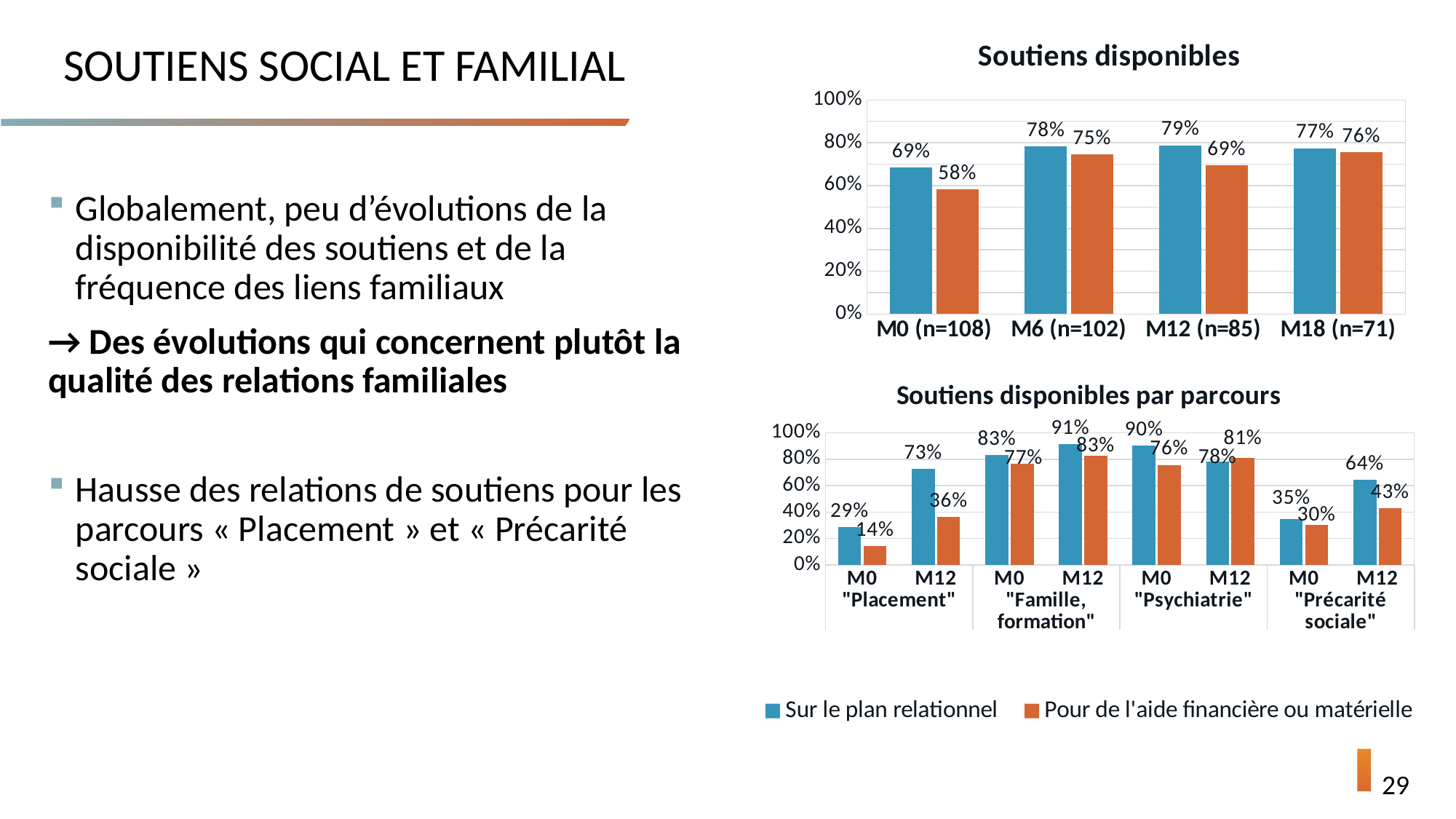
In the 'Soutiens disponibles' chart, how many time points are shown on the x axis? 4 In the 'Soutiens disponibles' chart, at which time point is 'Sur le plan relationnel' highest? M12 (n=85) In the 'Soutiens disponibles' chart, what is the value for 'Pour de l'aide financière ou matérielle' at M12 (n=85)? 69% In the 'Soutiens disponibles par parcours' chart, what is the difference between M0 and M12 for 'Sur le plan relationnel' in the 'Placement' parcours? 44 percentage points In the 'Soutiens disponibles par parcours' chart, what is the value for 'Sur le plan relationnel' at M12 'Placement'? 73% How many series does the legend list? 2 In the 'Soutiens disponibles par parcours' chart, which bar has the highest value overall? Sur le plan relationnel, M12 'Famille, formation' (91%) In the 'Soutiens disponibles par parcours' chart, what is the value for 'Pour de l'aide financière ou matérielle' at M0 'Précarité sociale'? 30% In the 'Soutiens disponibles par parcours' chart, which is larger at M12 'Psychiatrie': 'Sur le plan relationnel' or 'Pour de l'aide financière ou matérielle'? Pour de l'aide financière ou matérielle In the 'Soutiens disponibles' chart, what is the value for 'Sur le plan relationnel' at M0 (n=108)? 69% In the 'Soutiens disponibles' chart, what is the difference between the two series at M0 (n=108)? 11 percentage points In the 'Soutiens disponibles' chart, at which time point is 'Pour de l'aide financière ou matérielle' lowest? M0 (n=108)